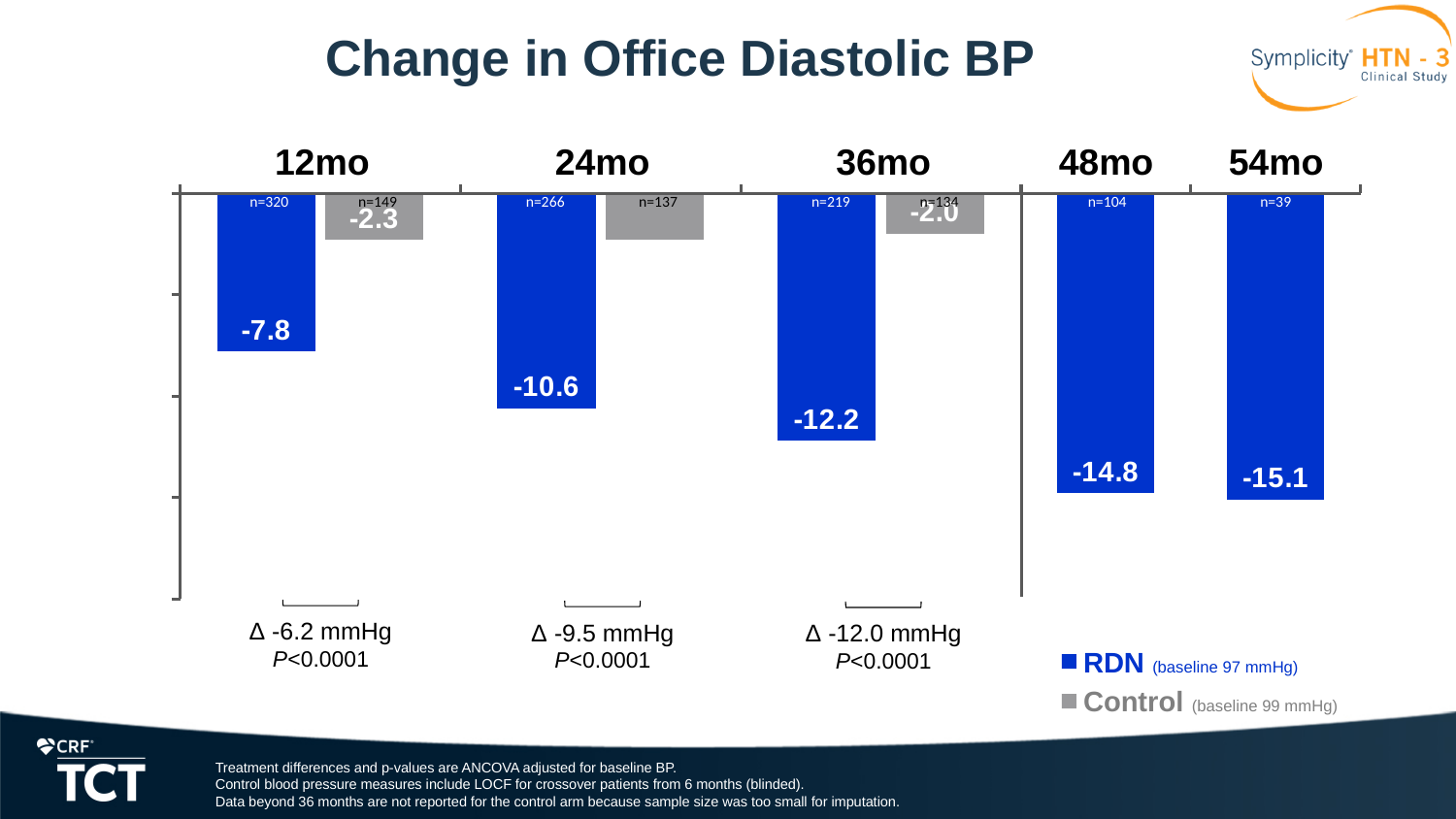
What is the sample size (n) for the RDN group at 48mo? n=104 What is the change in office diastolic BP for the Control group at 12mo? -2.3 What is the treatment difference (Δ) shown at 24mo? -9.5 mmHg What is the change in office diastolic BP for the RDN group at 12mo? -7.8 What is the change in office diastolic BP for the RDN group at 54mo? -15.1 What kind of chart is shown on the slide? Bar chart How many series does the legend list? 2 What is the difference between the RDN change at 36mo (-12.2) and at 12mo (-7.8)? 4.4 What is the change in office diastolic BP for the RDN group at 36mo? -12.2 At which time point does the RDN group show the smallest reduction in office diastolic BP? 12mo How many time points are shown on the x axis of the chart? 5 At which time point does the RDN group show the largest reduction in office diastolic BP? 54mo